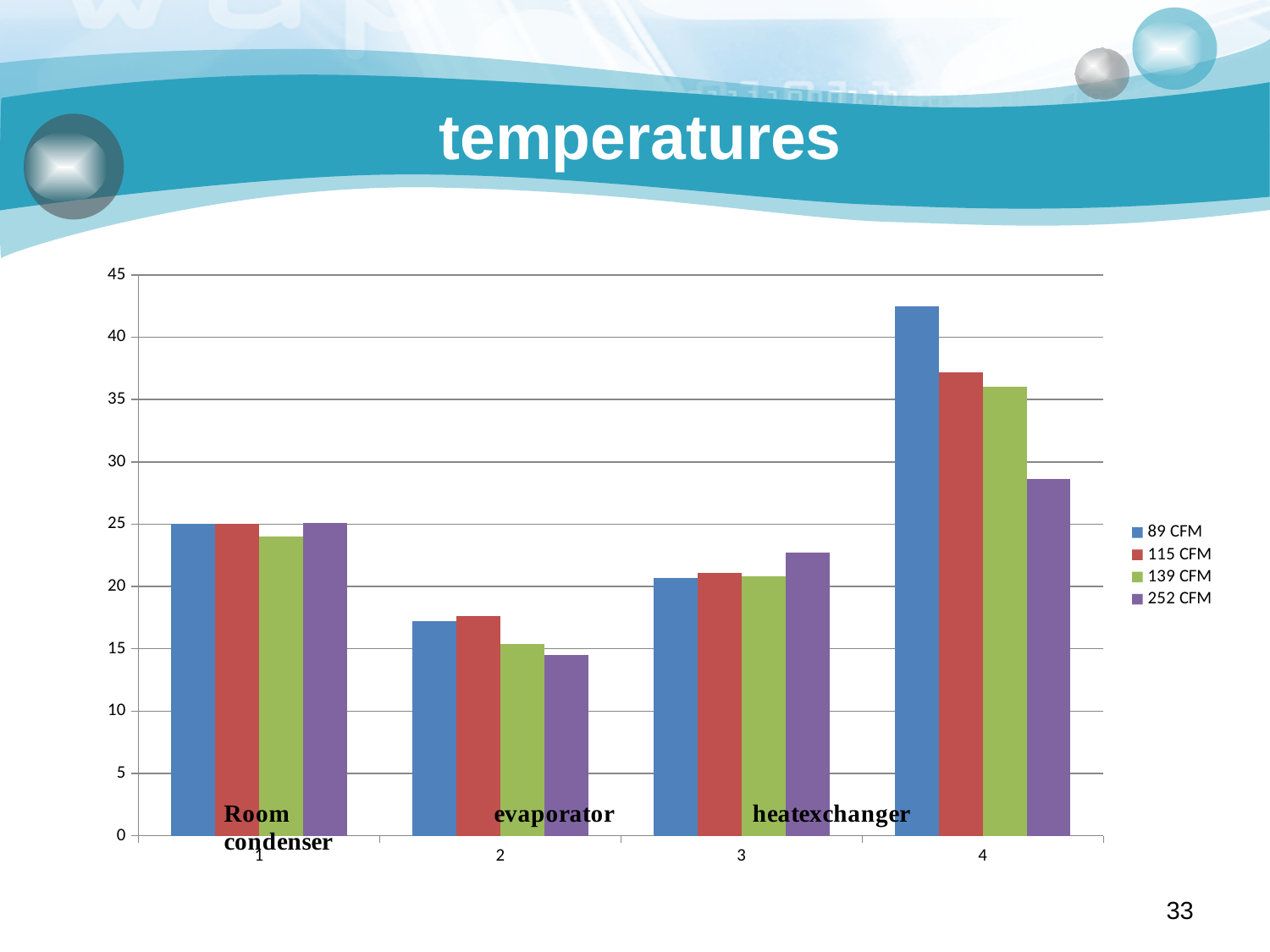
How many series does the legend list? 4 What is the title of the chart? temperatures How many categories are shown along the x axis? 4 What kind of chart is shown on the slide? bar chart Is the value for 252 CFM at category 2 greater or less than 15? less Which category has the highest value for the 89 CFM series? 4 Is the value for 89 CFM at category 4 greater or less than 40? greater Which category has the lowest value for the 252 CFM series? 2 At category 2, which is larger: the 115 CFM value or the 139 CFM value? 115 CFM Is the value for 252 CFM at category 4 greater or less than 30? less At category 4, which is larger: the 89 CFM value or the 252 CFM value? 89 CFM Which series is shown in purple in the legend? 252 CFM